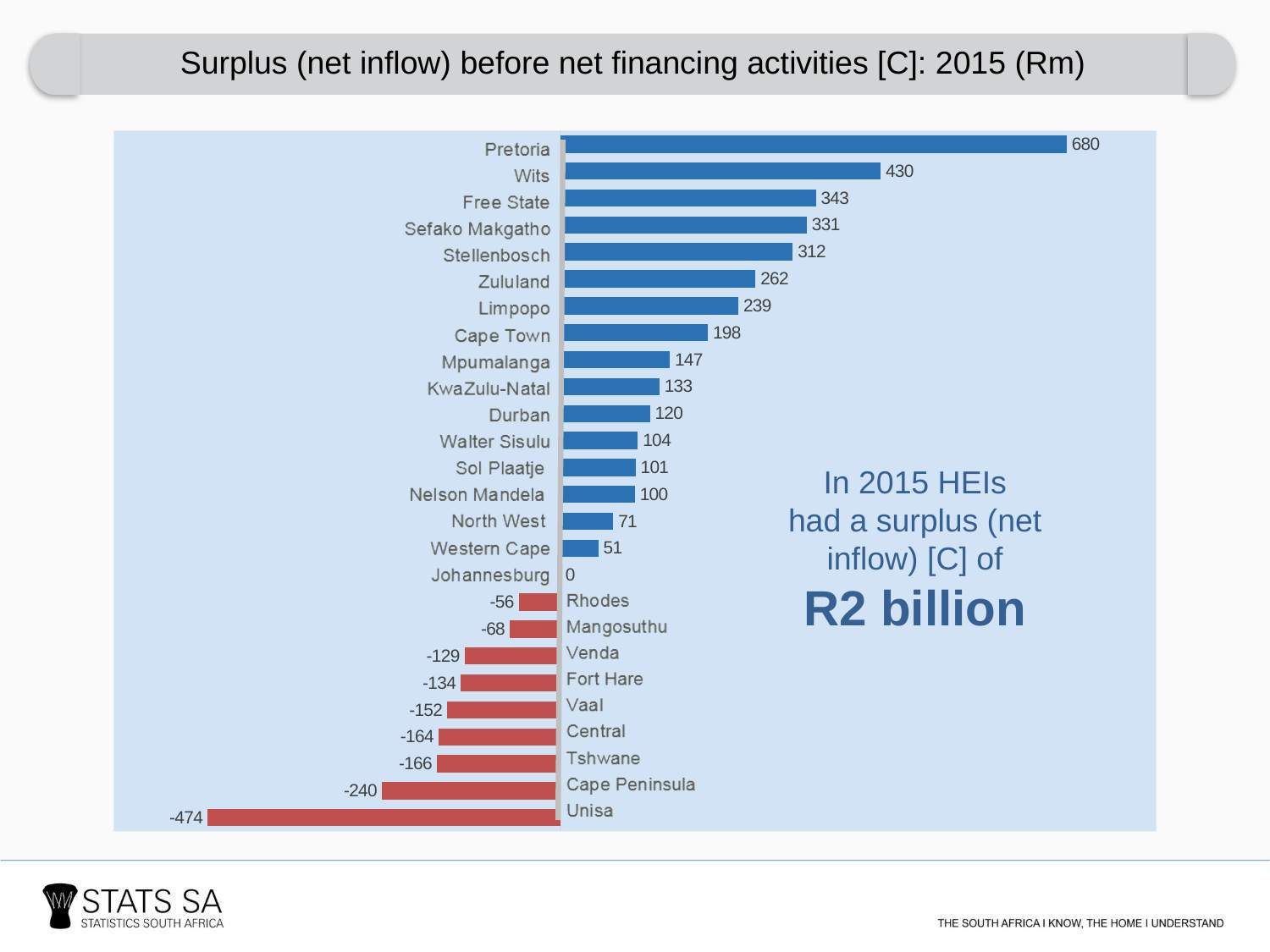
What is the value for Stellenbosch? 312 What is the value for Pretoria? 680 What is the value for Cape Peninsula? -240 Which institution has the lowest value? Unisa What is the difference between the values for Pretoria and Wits? 250 Which is larger, the value for Zululand or the value for Limpopo? Zululand What is the value for Johannesburg? 0 What is the title of the chart? Surplus (net inflow) before net financing activities [C]: 2015 (Rm) What is the value for Unisa? -474 Which institution has the highest surplus? Pretoria What kind of chart is shown on the slide? Bar chart How many institutions are shown in the chart? 26